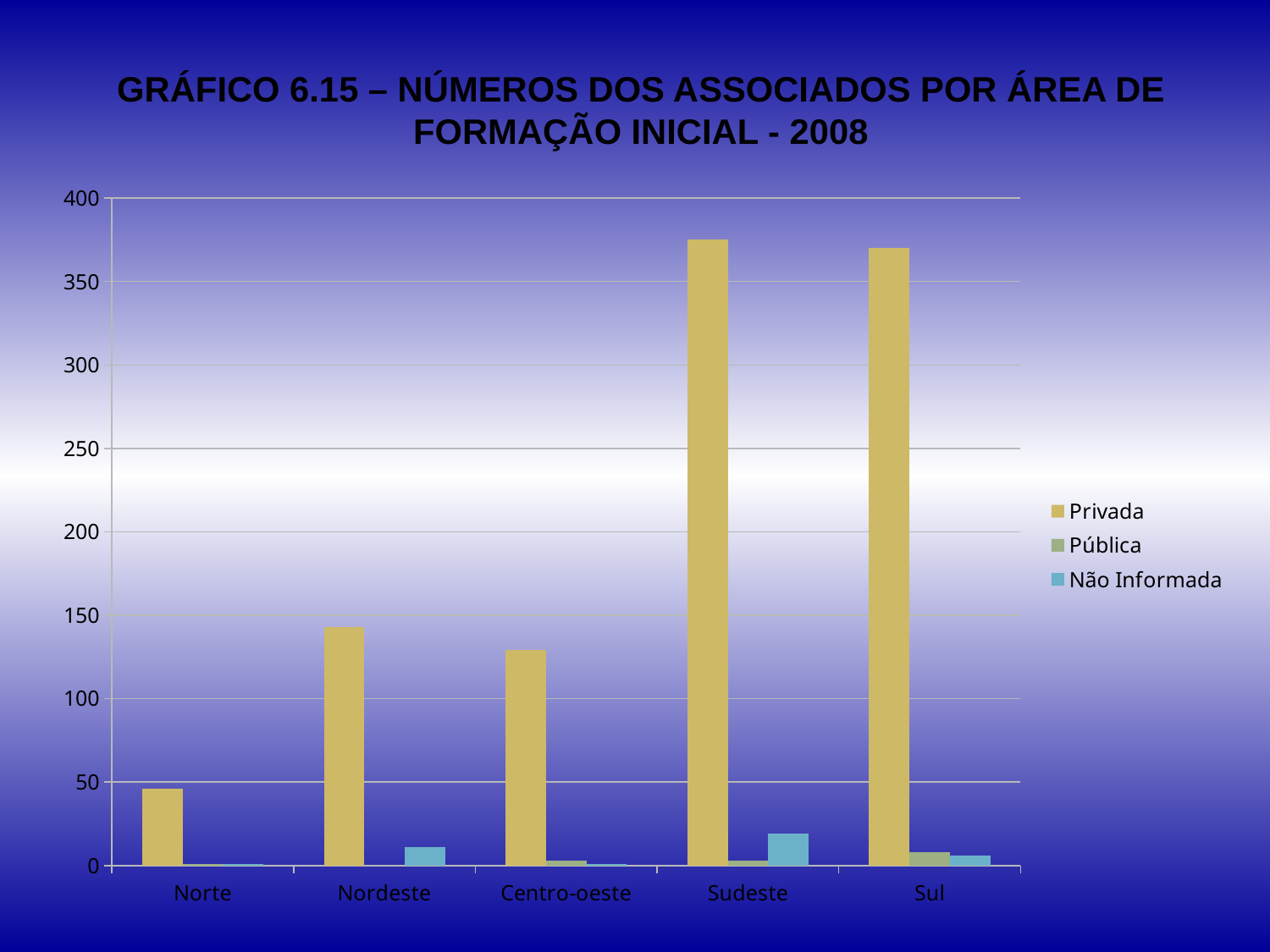
How many regions are shown on the x axis? 5 Which is larger, the Privada value for Nordeste or for Centro-oeste? Nordeste Is the Privada value for Norte greater or less than 50? less Is the Privada value for Sudeste greater or less than 350? greater Is the Privada value for Nordeste greater or less than 150? less Which series is shown in yellow in the legend? Privada How many series does the legend list? 3 What kind of chart is shown on the slide? Bar chart Which is larger, the Não Informada value for Sudeste or for Sul? Sudeste Which region has the highest value for Não Informada? Sudeste Which region has the lowest value for Privada? Norte